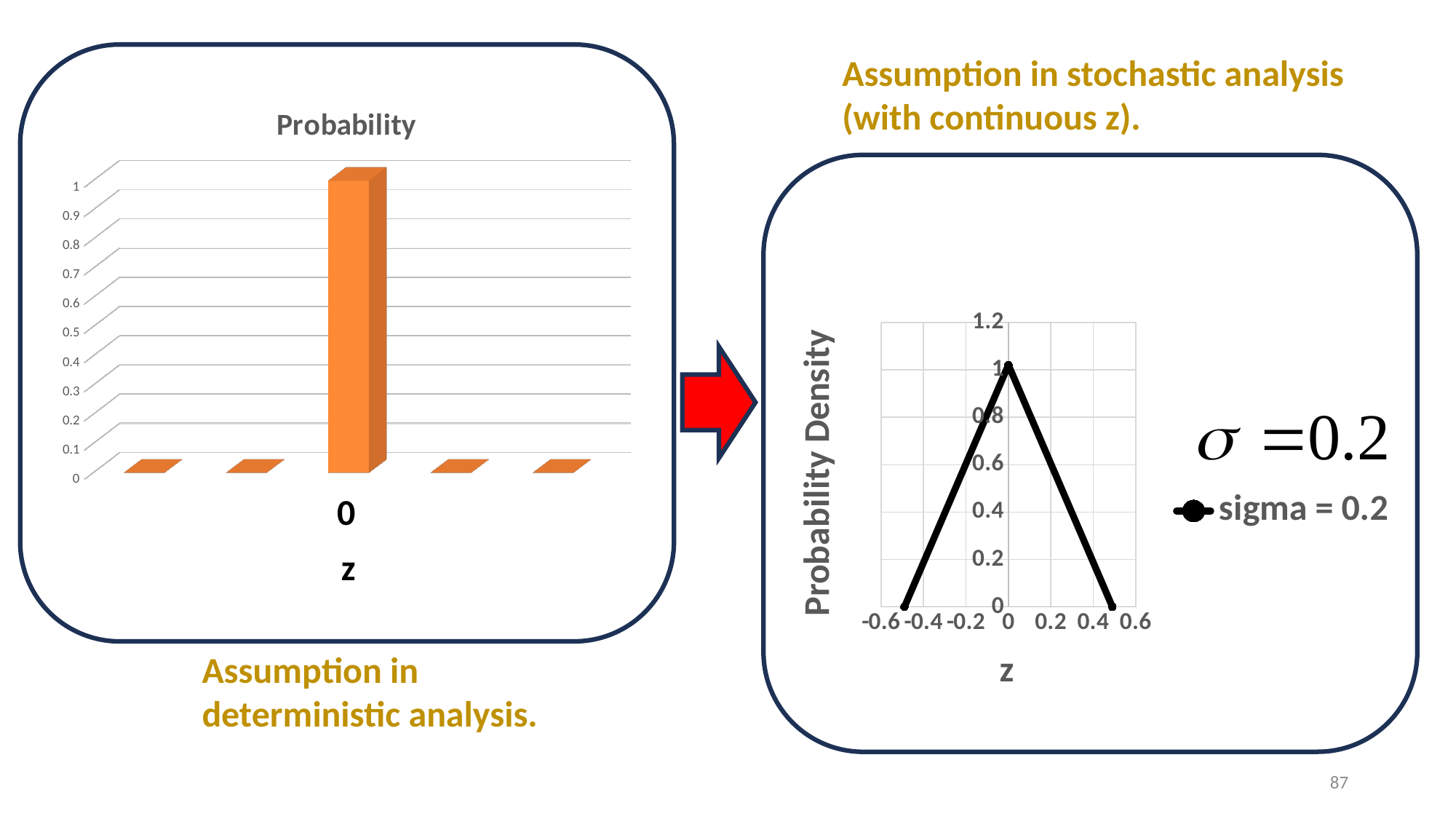
In the left chart titled "Probability", is the tall bar at z = 0 greater or less than 0.5? greater What kind of chart is the left chart titled "Probability"? bar chart In the right chart with the y-axis "Probability Density", is the value at z = 0.2 greater or less than 0.4? greater In the right chart with the y-axis "Probability Density", does the line rise or fall as z goes from 0 to 0.4? fall In the left chart titled "Probability", what is the value of the tall bar at z = 0? 1 What kind of chart is the right chart with the y-axis "Probability Density"? line chart In the right chart with the y-axis "Probability Density", is the value at z = -0.4 greater or less than 0.4? less In the right chart with the y-axis "Probability Density", what is the legend entry? sigma = 0.2 In the right chart with the y-axis "Probability Density", how many series does the legend list? 1 What is the title of the left chart? Probability In the left chart titled "Probability", how many bars are plotted? 5